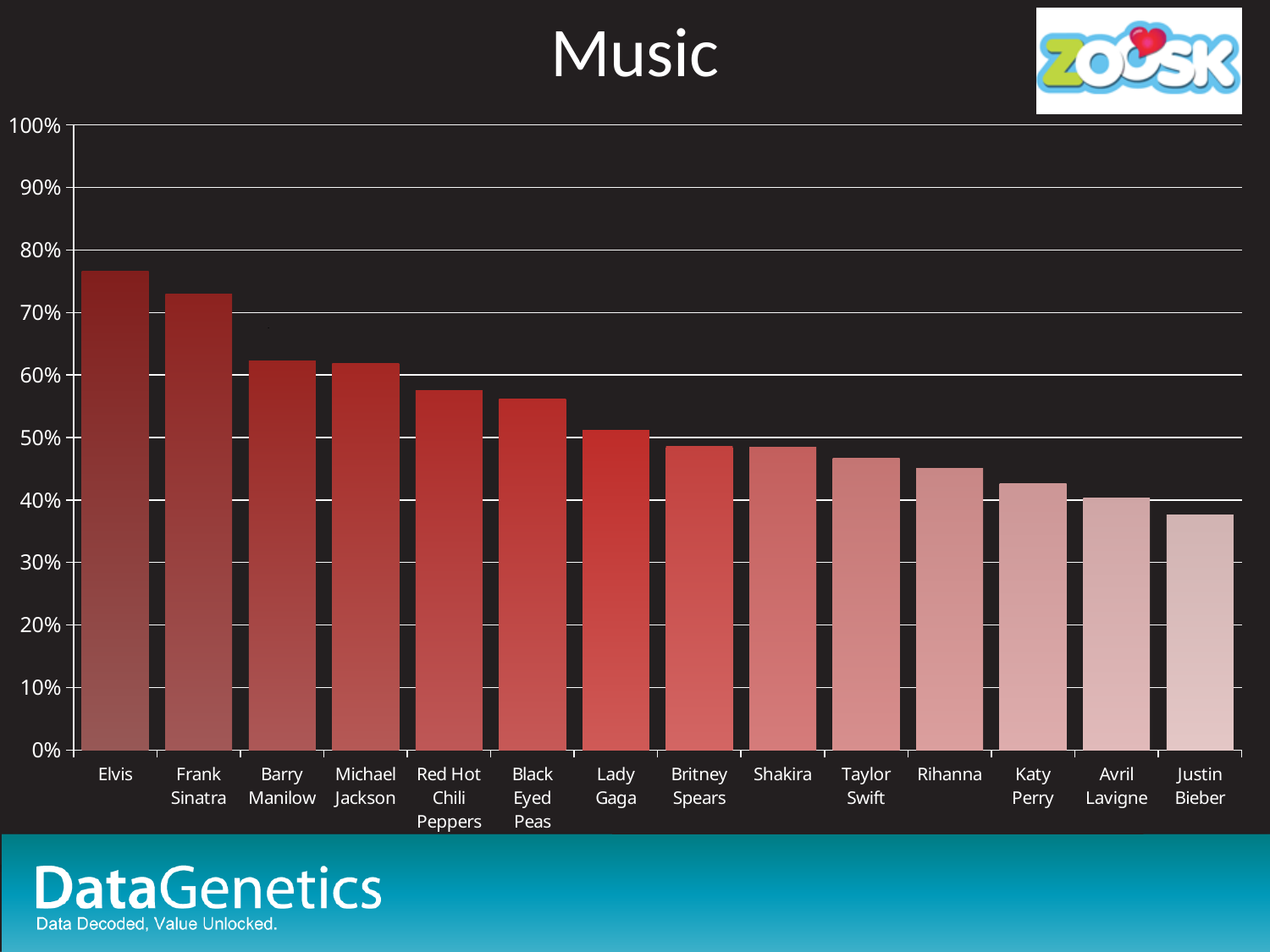
Is the value for Taylor Swift greater or less than 50%? less How many artists are shown on the x axis of the chart? 14 Which is larger, the value for Frank Sinatra or the value for Lady Gaga? Frank Sinatra Which artist has the lowest bar in the chart? Justin Bieber What is the title of the slide containing the chart? Music Is the value for Elvis greater or less than 70%? greater What kind of chart is shown on the slide? bar chart Is the value for Justin Bieber greater or less than 40%? less Do the bar values rise or fall moving from left to right along the x axis? fall Which artist has the highest bar in the chart? Elvis